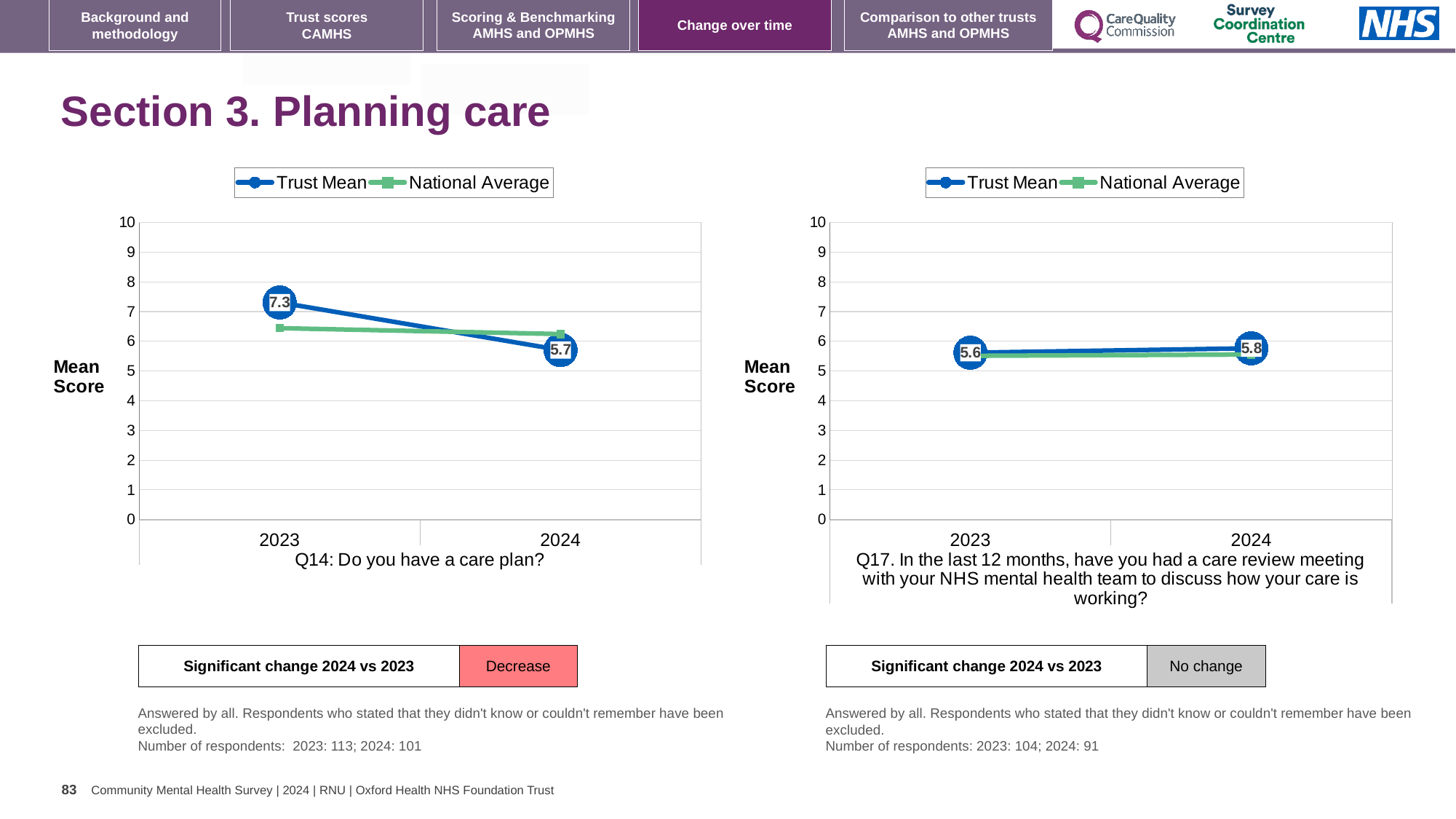
How many series does the legend of the left chart (Q14) list? 2 In the right chart (Q17), does the Trust Mean rise or fall from 2023 to 2024? rise In the left chart (Q14: Do you have a care plan?), what is the Trust Mean for 2024? 5.7 In the right chart (Q17), what is the difference between the Trust Mean in 2024 and in 2023? 0.2 In the right chart (Q17 care review meeting), what is the Trust Mean for 2023? 5.6 What type of chart is used on this slide? line chart In the left chart (Q14: Do you have a care plan?), what is the Trust Mean for 2023? 7.3 In the left chart (Q14), which is larger in 2023: the Trust Mean or the National Average? Trust Mean In the right chart (Q17 care review meeting), what is the Trust Mean for 2024? 5.8 In the left chart (Q14), does the Trust Mean rise or fall from 2023 to 2024? fall In the left chart (Q14), is the National Average for 2023 greater or less than 6? greater In the left chart (Q14), by how much did the Trust Mean fall from 2023 to 2024? 1.6